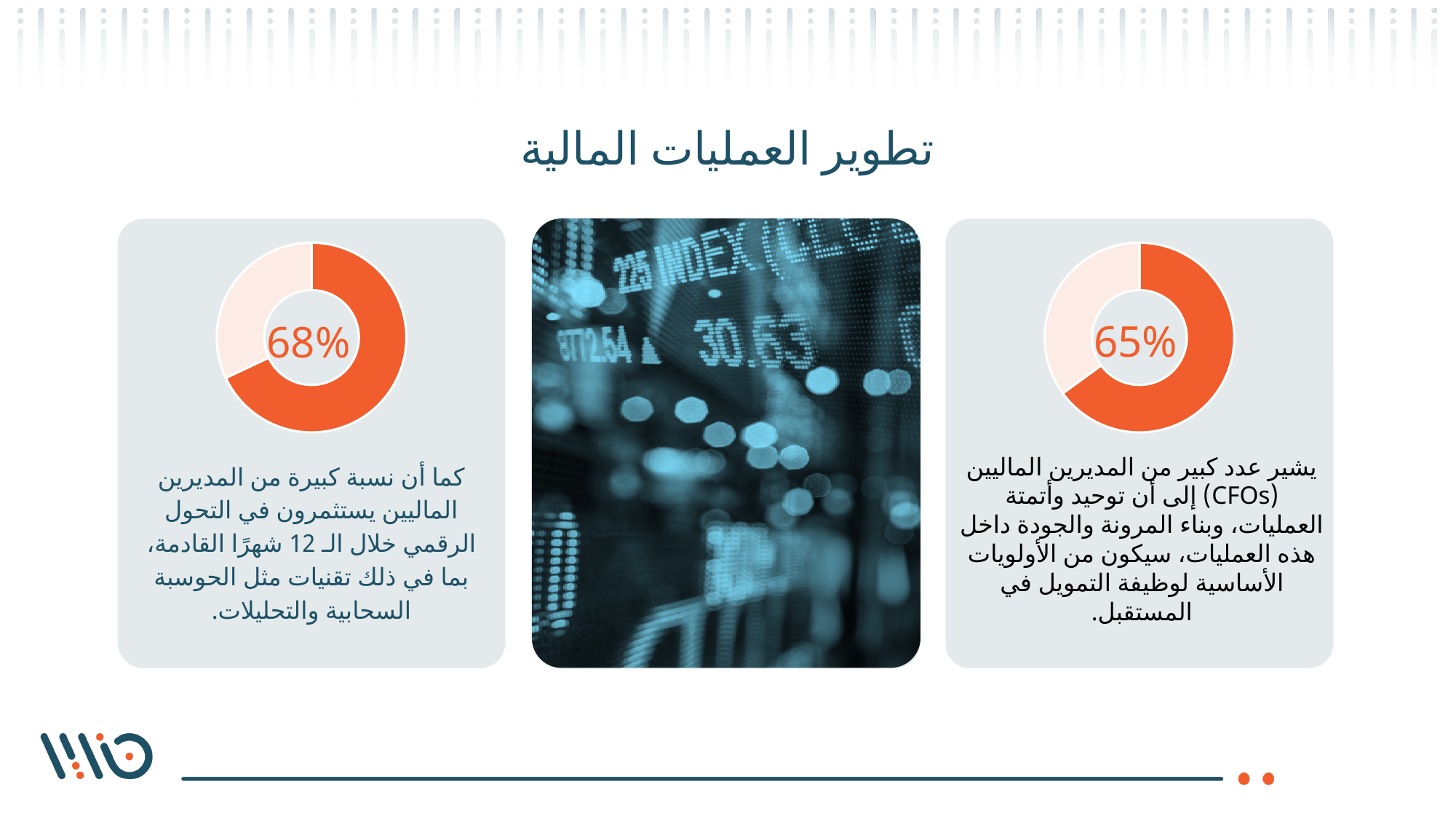
What is the title of the slide containing the two donut charts? تطوير العمليات المالية What is the difference between the percentage in the left donut chart and the percentage in the right donut chart? 3 percentage points How many donut charts are on the slide? 2 In the right donut chart, what share of the ring is not covered by the orange segment? 35% In the left donut chart, what share of the ring is not covered by the orange segment? 32% What kind of chart is used on the left of the slide? donut chart What value is shown in the centre of the donut chart on the left of the slide? 68% What value is shown in the centre of the donut chart on the right of the slide? 65% What kind of chart is used on the right of the slide? donut chart What colour is the highlighted segment in both donut charts? orange Which donut chart shows the larger percentage, the one on the left or the one on the right? the one on the left